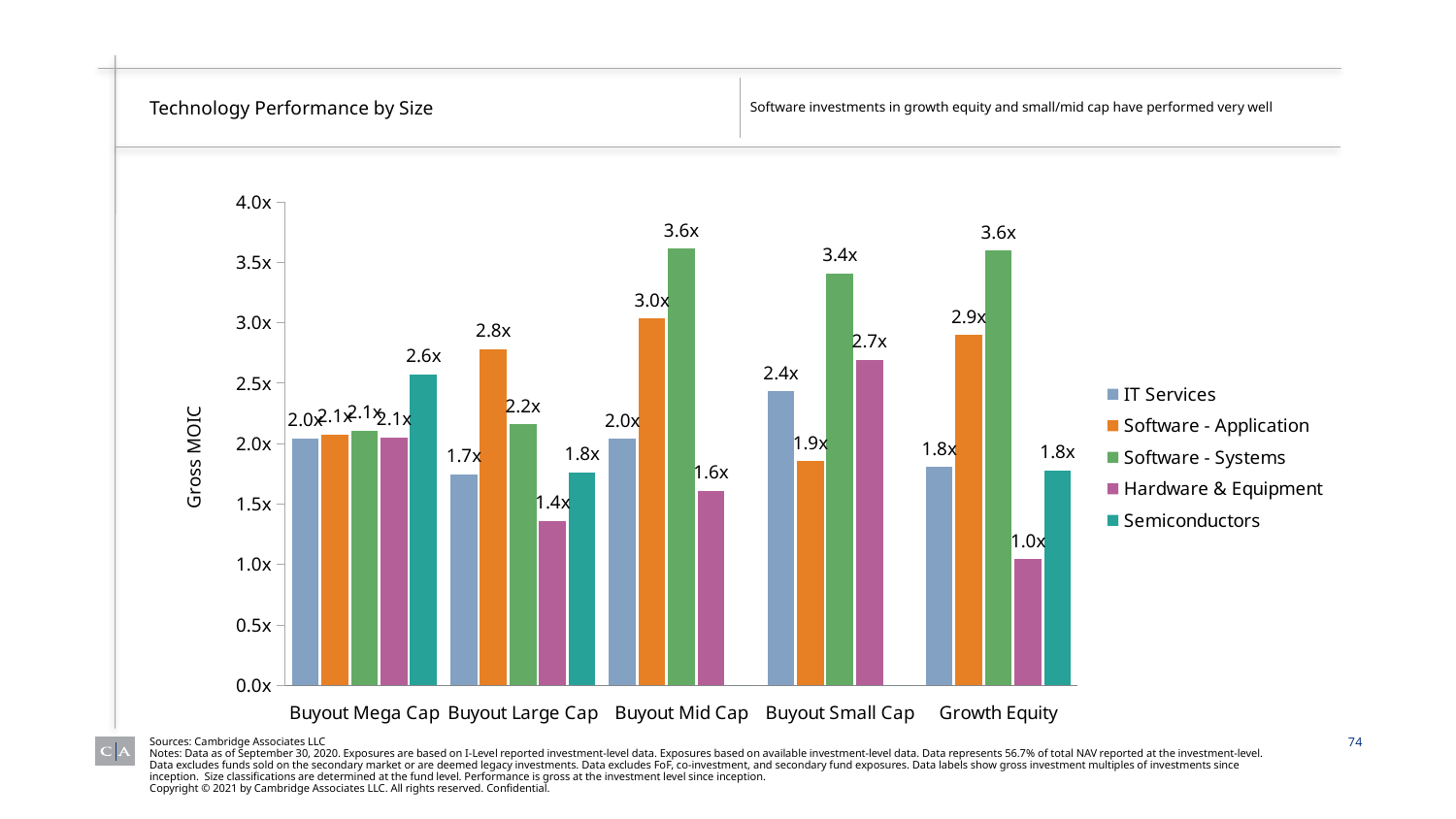
What is the Gross MOIC for Semiconductors in the Buyout Mega Cap category? 2.6x In the Growth Equity category, what is the difference between the Gross MOIC for Software - Systems and Hardware & Equipment? 2.6x What is the Gross MOIC for Software - Systems in the Buyout Mid Cap category? 3.6x In the Buyout Large Cap category, how much higher is the Gross MOIC for Software - Application than for IT Services? 1.1x How many size categories are shown on the x axis? 5 What is the Gross MOIC for Hardware & Equipment in the Growth Equity category? 1.0x Is the Gross MOIC for Software - Systems in Growth Equity greater or less than 3.0x? greater What kind of chart is shown on the slide? Bar chart How many series does the legend list? 5 In the Buyout Small Cap category, which is larger: the Gross MOIC for IT Services or for Software - Application? IT Services Which series has the lowest Gross MOIC in the Buyout Large Cap category? Hardware & Equipment Which series has the highest Gross MOIC in the Buyout Small Cap category? Software - Systems